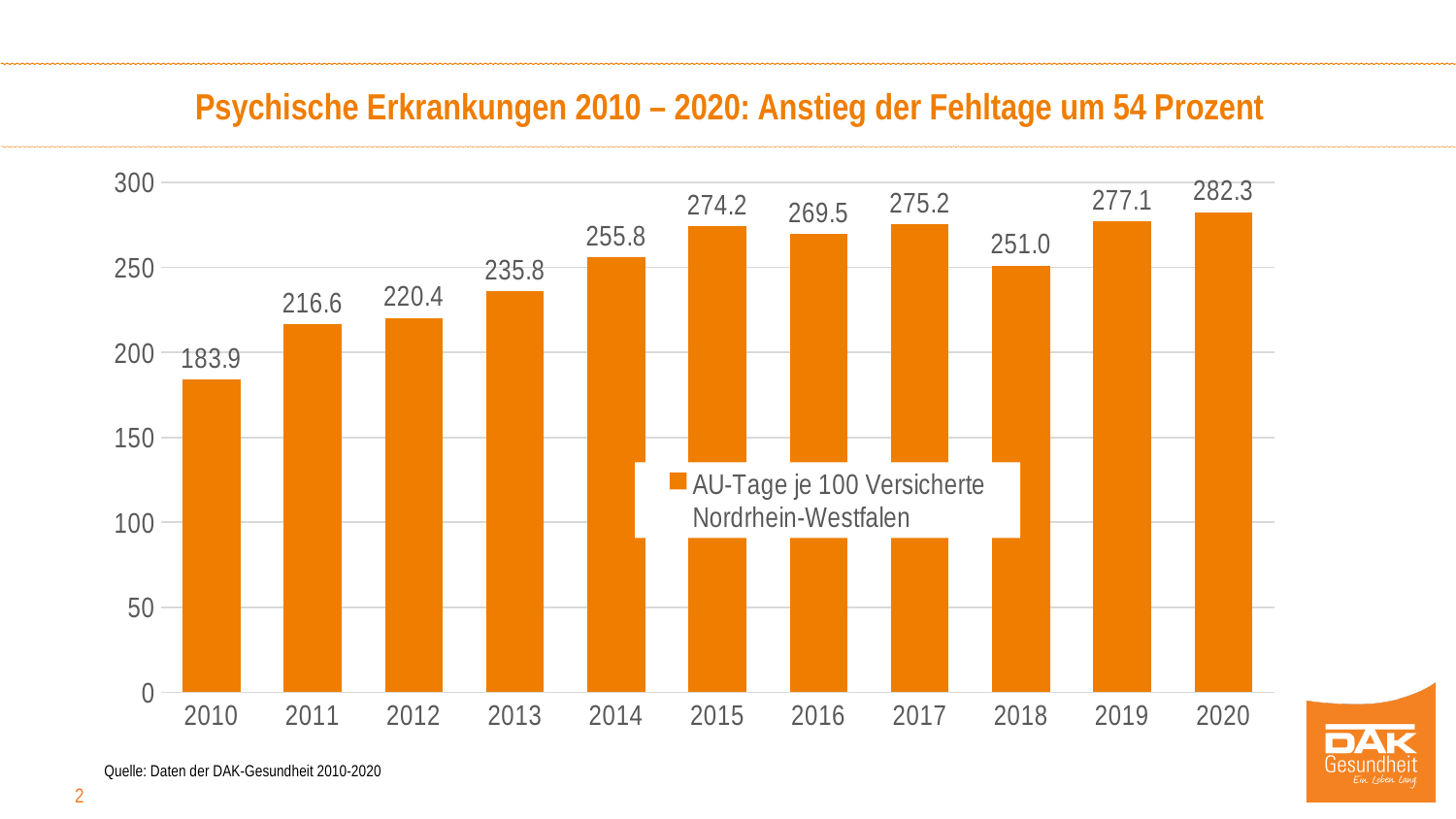
What is the value for 2010? 183.9 What is the value for 2018? 251.0 How many years are shown on the x axis? 11 What is the series name shown in the legend? AU-Tage je 100 Versicherte Nordrhein-Westfalen Which year has the lowest value? 2010 What is the value for 2015? 274.2 Which is larger, the value for 2017 or the value for 2018? 2017 What is the difference between the values for 2020 and 2010? 98.4 Is the value for 2013 greater or less than 250? less How many series does the legend list? 1 What kind of chart is shown? bar chart Which year has the highest value? 2020